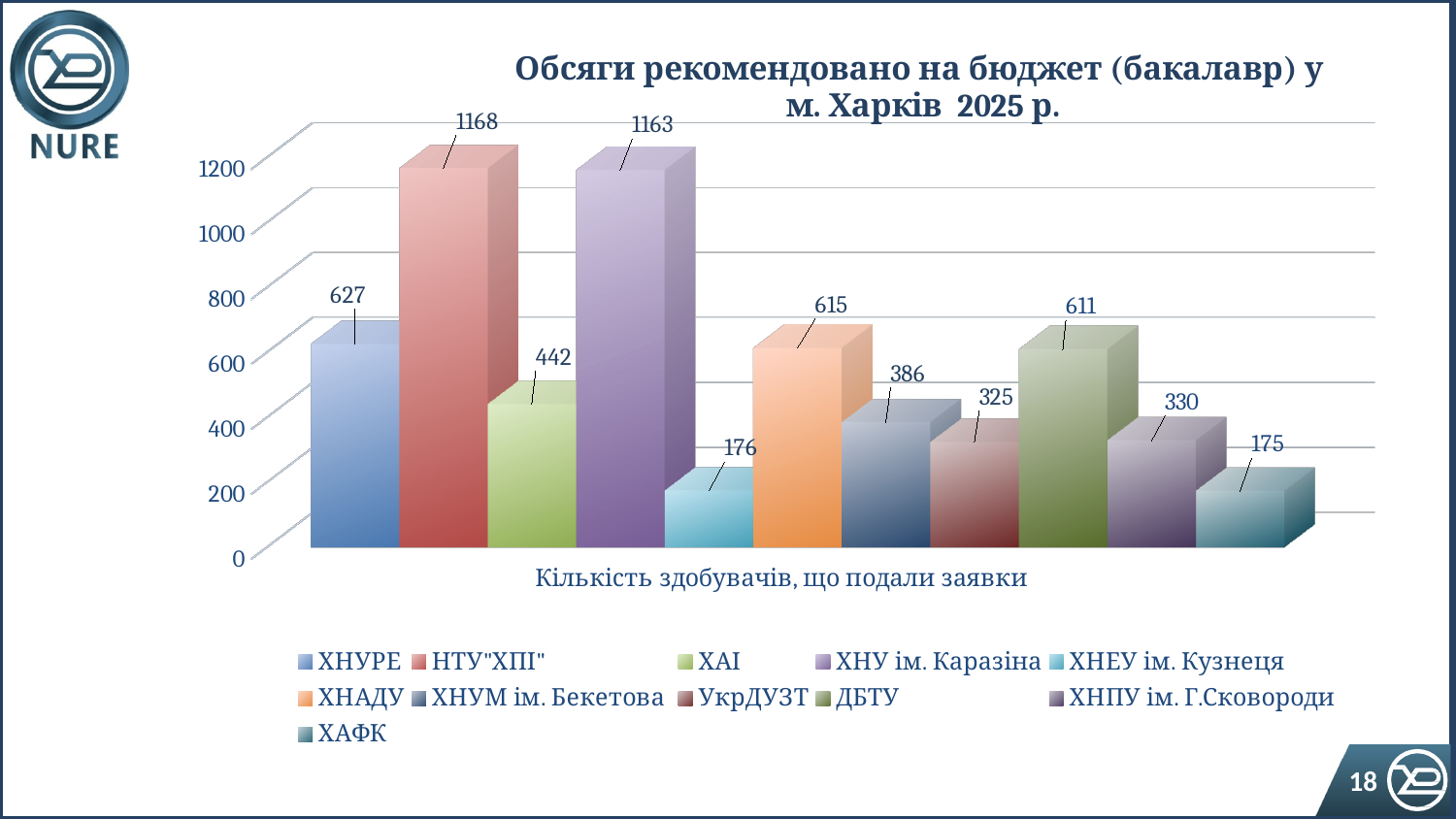
What is the title of the chart? Обсяги рекомендовано на бюджет (бакалавр) у м. Харків 2025 р. Is the value for ДБТУ greater or less than 400? greater Which is larger, the value for ХАІ or the value for ХНУМ ім. Бекетова? ХАІ What is the value for УкрДУЗТ? 325 What is the value for ХНУ ім. Каразіна? 1163 What is the difference between the values for НТУ"ХПІ" and ХНУРЕ? 541 How many series does the legend list? 11 Which university has the highest value? НТУ"ХПІ" What is the value for ХНАДУ? 615 Which university has the lowest value? ХАФК What kind of chart is shown on the slide? bar chart What is the value for ХНУРЕ? 627